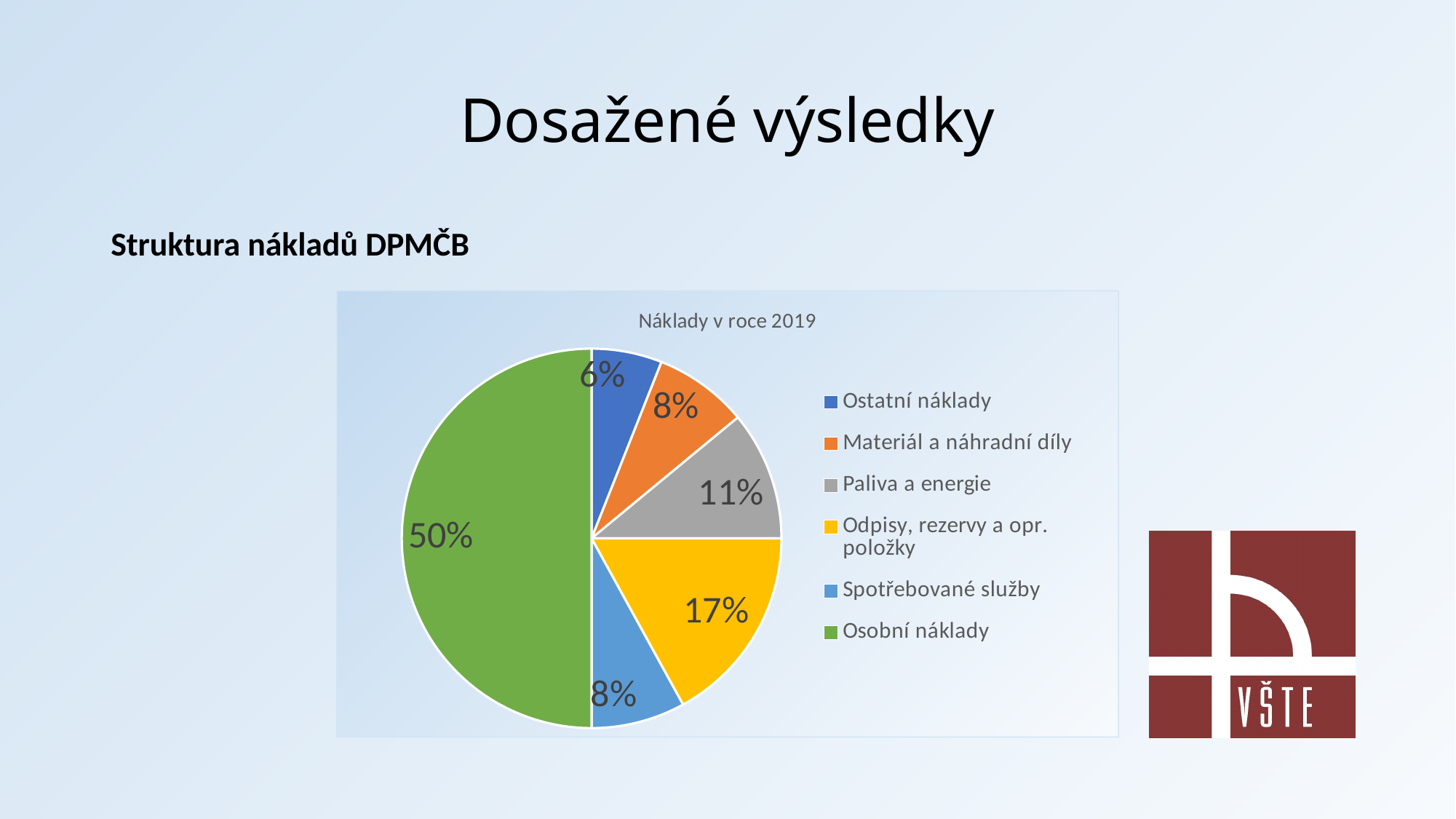
What kind of chart is shown on the slide? pie chart What is the value for Materiál a náhradní díly? 8% What is the value for Ostatní náklady? 6% What share of the pie does Osobní náklady take? 50% How many categories does the legend list? 6 What is the title of the chart? Náklady v roce 2019 What is the value for Odpisy, rezervy a opr. položky? 17% What is the value for Paliva a energie? 11% Which category has the largest share of the pie? Osobní náklady Which is larger, the share for Paliva a energie or the share for Spotřebované služby? Paliva a energie What is the difference between the shares of Osobní náklady and Odpisy, rezervy a opr. položky? 33% Which category has the smallest share of the pie? Ostatní náklady